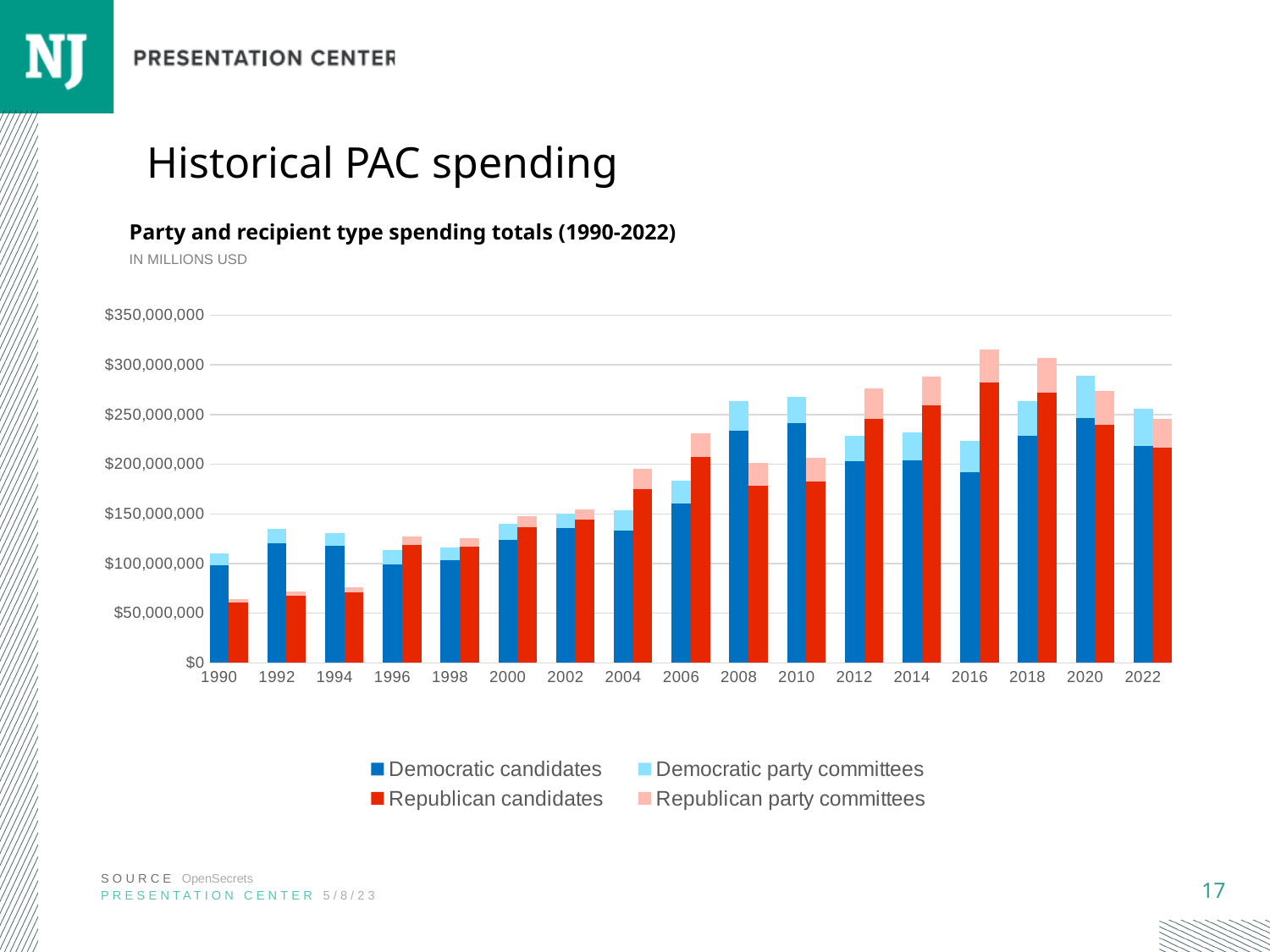
Which year has the shortest Republican stacked bar? 1990 How many election years are shown along the x axis? 17 Which year has the tallest Democratic stacked bar? 2020 In 1990, which stacked bar is taller, the Democratic one or the Republican one? Democratic In 2016, which stacked bar is taller, the Democratic one or the Republican one? Republican What unit are the values on the chart expressed in, according to the subtitle? Millions USD How many series does the legend list? 4 What kind of chart is shown on the slide? Stacked bar chart Which year has the tallest Republican stacked bar? 2016 Is the total Republican stacked bar in 1990 greater or less than $100,000,000? less Is the value for Republican candidates in 2016 greater or less than $250,000,000? greater